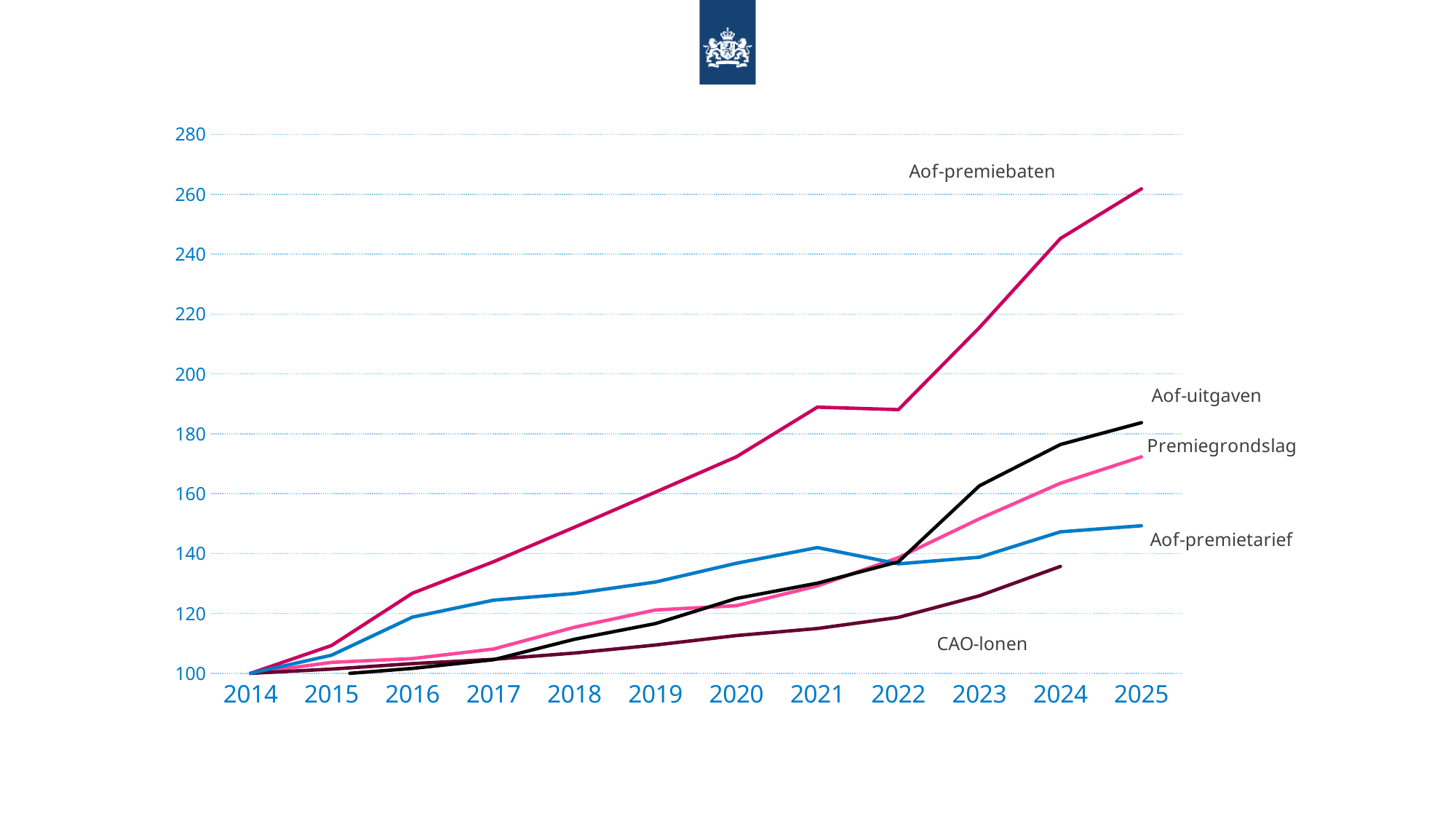
Which series has the highest value in 2025? Aof-premiebaten How many years are shown along the x axis? 12 Does the Aof-premiebaten line generally rise or fall from 2014 to 2025? rise Is the value for CAO-lonen in 2024 greater or less than 140? less Which series has the lowest value in 2024? CAO-lonen What kind of chart is shown on the slide? line chart At what value do all the series start in 2014? 100 How many labelled series are plotted on the chart? 5 Is the value for Premiegrondslag in 2025 greater or less than 180? less Is the value for Aof-premiebaten in 2025 greater or less than 240? greater In 2025, which is larger: Aof-uitgaven or Premiegrondslag? Aof-uitgaven